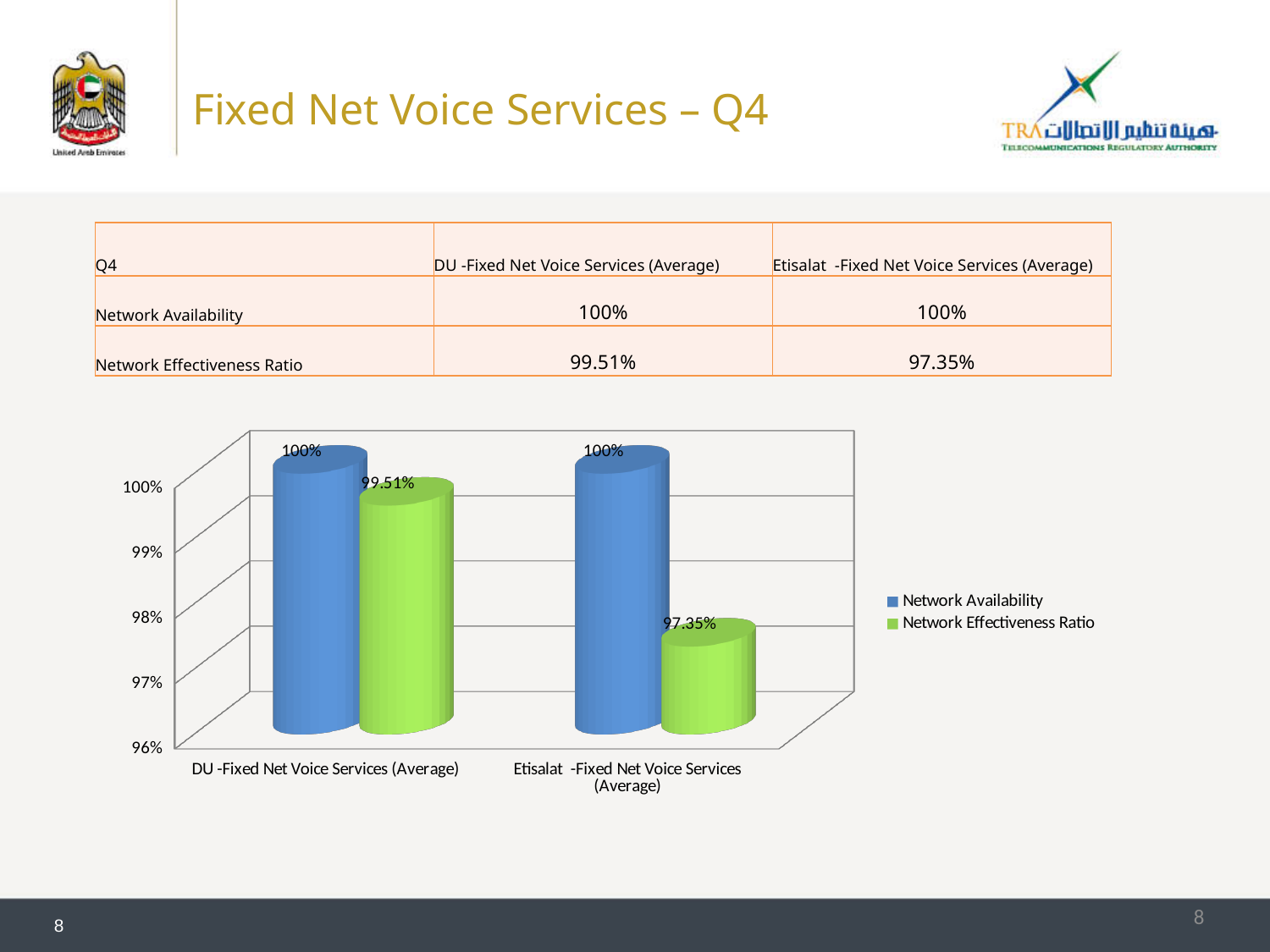
Which colour represents Network Effectiveness Ratio in the chart legend? Green What is the Network Availability value for Etisalat - Fixed Net Voice Services (Average)? 100% Is the Network Effectiveness Ratio for Etisalat greater or less than 98%? less Which operator has the lower Network Effectiveness Ratio? Etisalat - Fixed Net Voice Services (Average) Which is larger: DU's Network Effectiveness Ratio or Etisalat's Network Effectiveness Ratio? DU's Network Effectiveness Ratio What is the Network Effectiveness Ratio for DU - Fixed Net Voice Services (Average)? 99.51% What kind of chart is shown on the slide? Bar chart How many operator categories are shown on the x axis of the chart? 2 What is the difference between the Network Effectiveness Ratio of DU and Etisalat? 2.16% How many series does the chart legend list? 2 What is the difference between DU's Network Availability and its Network Effectiveness Ratio? 0.49% What is the Network Effectiveness Ratio for Etisalat - Fixed Net Voice Services (Average)? 97.35%